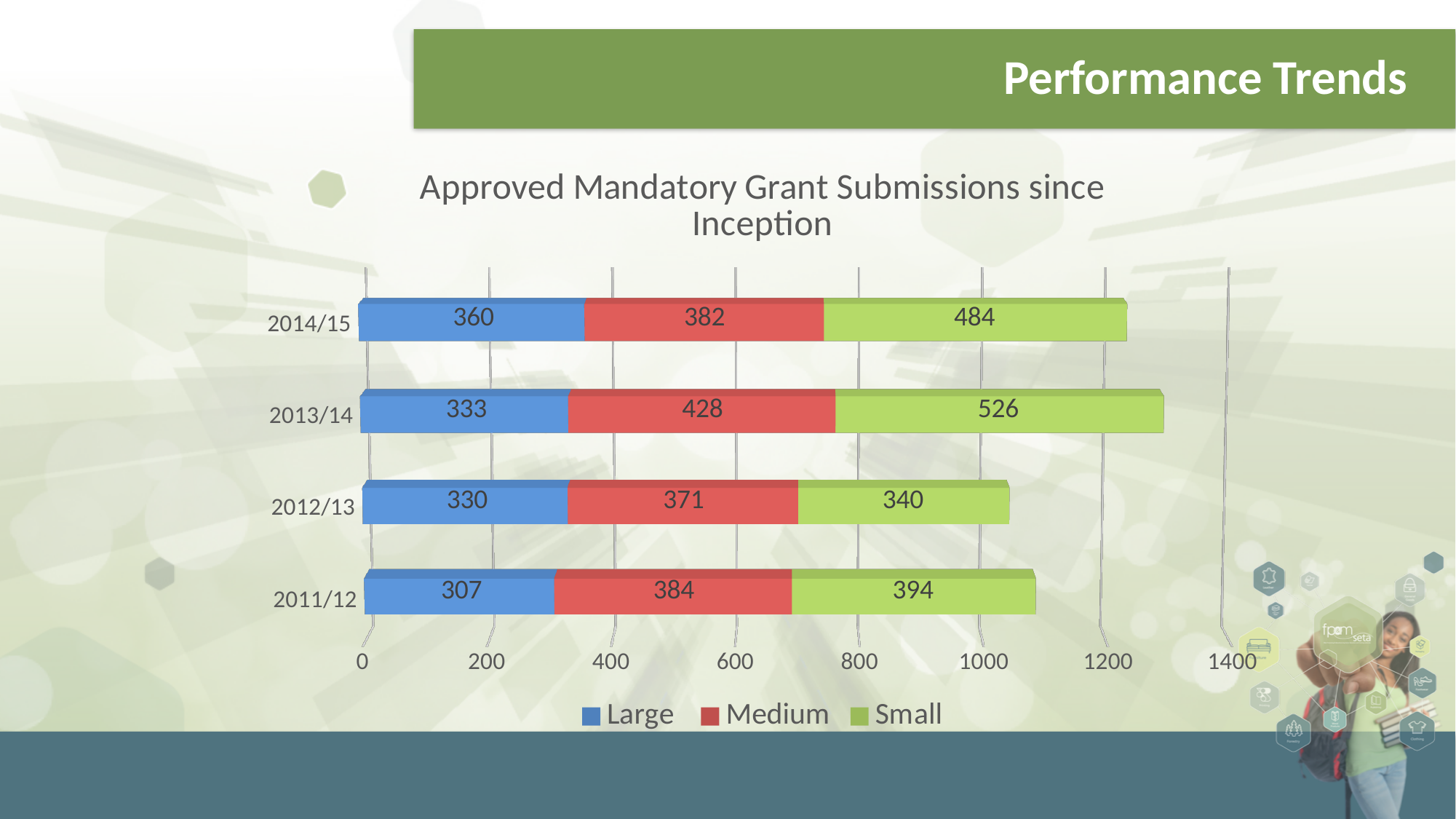
How many series does the legend list? 3 Which year has the lowest Large value? 2011/12 What is the difference between the Medium values for 2013/14 and 2012/13? 57 What is the Small value for 2013/14? 526 Which year has the highest Small value? 2013/14 How many years are shown on the chart? 4 Which is larger, the Small value for 2012/13 or the Small value for 2011/12? 2011/12 What is the total of the stacked bar for 2014/15? 1226 What is the total of the stacked bar for 2012/13? 1041 What is the Large value for 2011/12? 307 What kind of chart is shown on the slide? Stacked bar chart What is the Medium value for 2014/15? 382